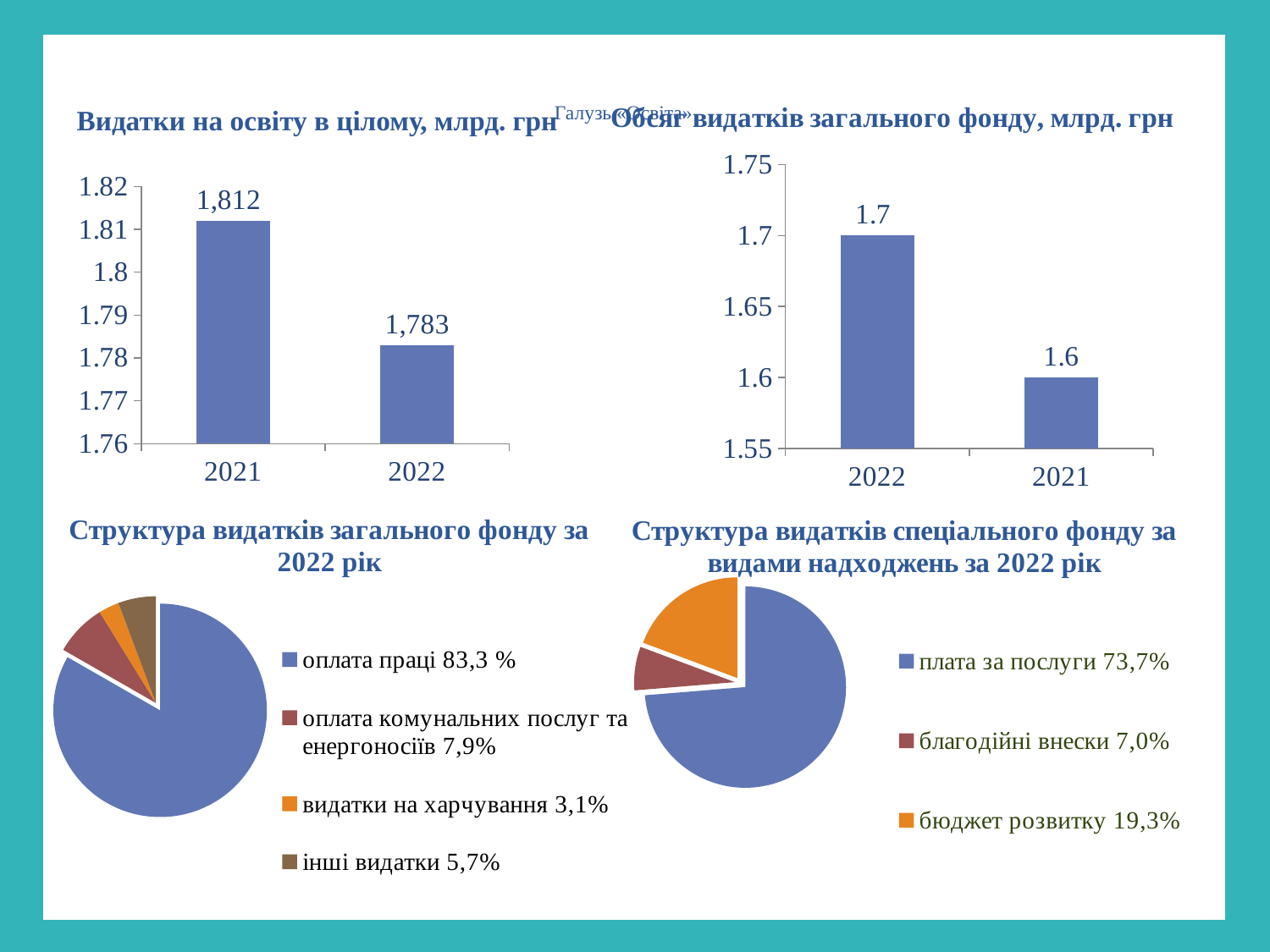
In the top-right bar chart, what is the value for 2022? 1.7 In the pie chart 'Структура видатків загального фонду за 2022 рік', how many categories does the legend list? 4 In the top-left chart 'Видатки на освіту в цілому, млрд. грн', what is the difference between the 2021 and 2022 values? 0,029 In the top-left chart 'Видатки на освіту в цілому, млрд. грн', what is the value for 2021? 1,812 In the pie chart 'Структура видатків спеціального фонду за видами надходжень за 2022 рік', which category has the smallest share? благодійні внески In the top-left chart 'Видатки на освіту в цілому, млрд. грн', what is the value for 2022? 1,783 In the top-left chart 'Видатки на освіту в цілому, млрд. грн', which year has the higher value? 2021 In the pie chart 'Структура видатків спеціального фонду за видами надходжень за 2022 рік', what share is 'бюджет розвитку'? 19,3% In the top-right bar chart, what is the value for 2021? 1.6 What type of chart is the top-right chart? bar chart In the pie chart 'Структура видатків загального фонду за 2022 рік', what share is 'оплата праці'? 83,3 % In the top-right bar chart, which year has the lower value? 2021